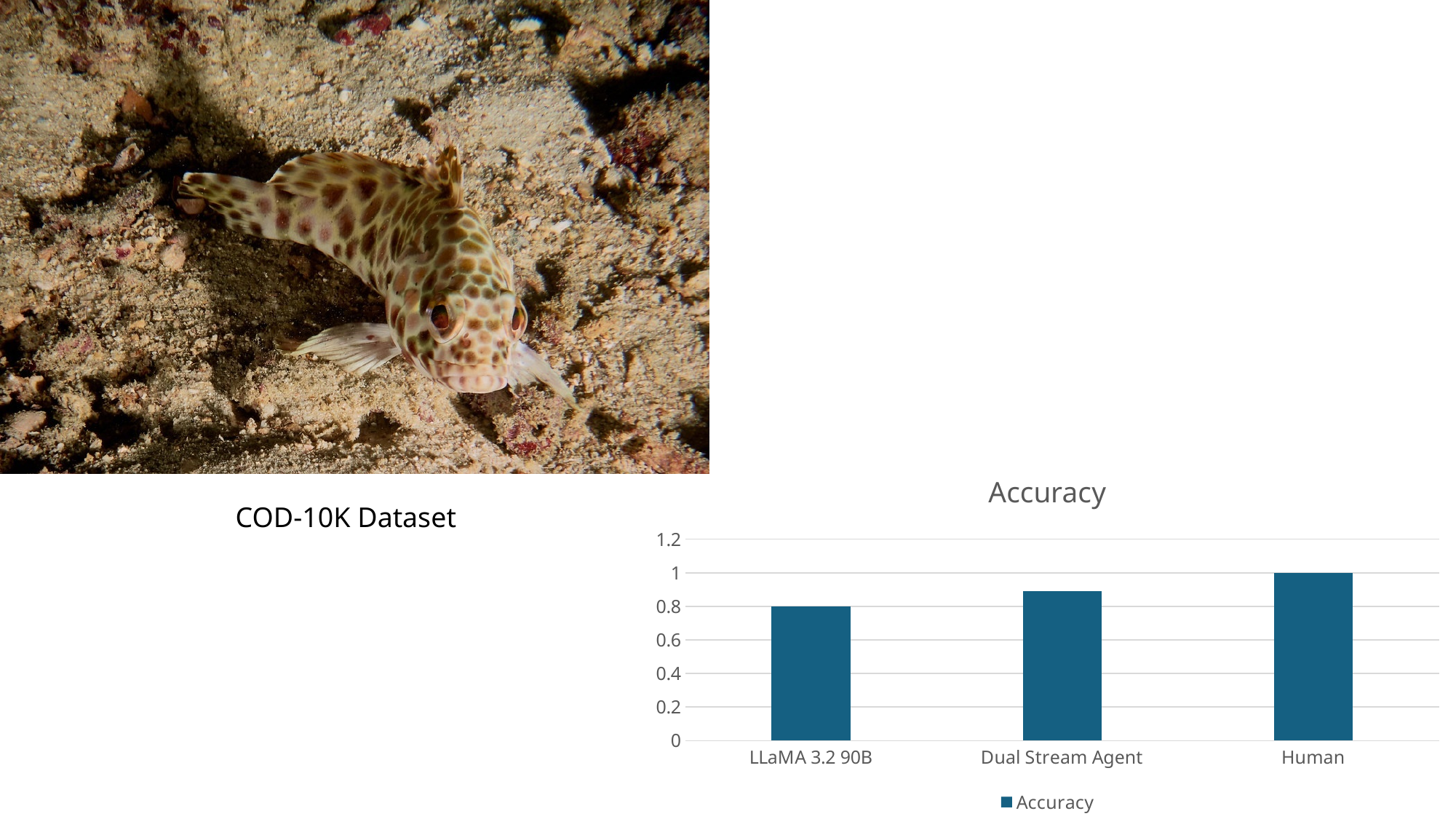
How many categories are plotted in the Accuracy chart? 3 How many series does the legend of the Accuracy chart list? 1 Is the accuracy value for Dual Stream Agent greater or less than 1? less Which has a higher accuracy, Dual Stream Agent or LLaMA 3.2 90B? Dual Stream Agent What is the accuracy value for Human? 1 Is the accuracy value for Dual Stream Agent greater or less than 0.8? greater What is the accuracy value for LLaMA 3.2 90B? 0.8 Which category has the highest accuracy in the chart? Human What kind of chart is shown on the slide? bar chart Which category has the lowest accuracy in the chart? LLaMA 3.2 90B What is the title of the chart on the slide? Accuracy Do the accuracy values rise or fall from left to right across the categories? rise